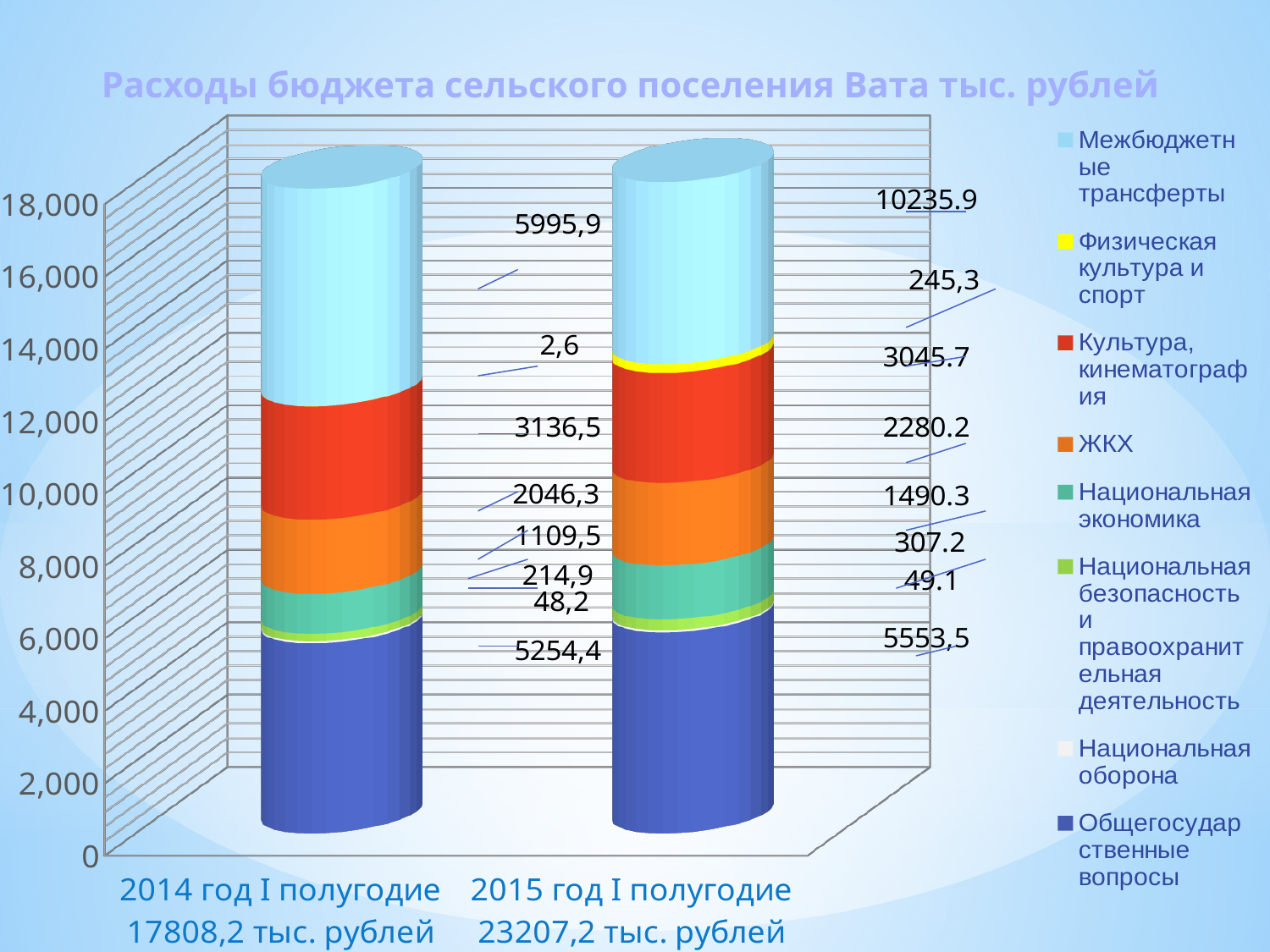
How many series does the legend list? 8 What kind of chart is shown on the slide? stacked bar chart What is the value of Межбюджетные трансферты for 2015 год I полугодие? 10235.9 What is the value of Межбюджетные трансферты for 2014 год I полугодие? 5995,9 What is the total of the stacked bar for 2014 год I полугодие, as printed on the slide? 17808,2 тыс. рублей How many bars (categories) are plotted on the chart? 2 What is the difference between the Общегосударственные вопросы values for 2015 (5553,5) and 2014 (5254,4)? 299,1 What is the value of Культура, кинематография for 2014 год I полугодие? 3136,5 Which year has the larger value for ЖКХ: 2014 год I полугодие (2046,3) or 2015 год I полугодие (2280.2)? 2015 год I полугодие What is the title of the chart? Расходы бюджета сельского поселения Вата тыс. рублей What is the total of the stacked bar for 2015 год I полугодие, as printed on the slide? 23207,2 тыс. рублей What is the value of Общегосударственные вопросы for 2015 год I полугодие? 5553,5